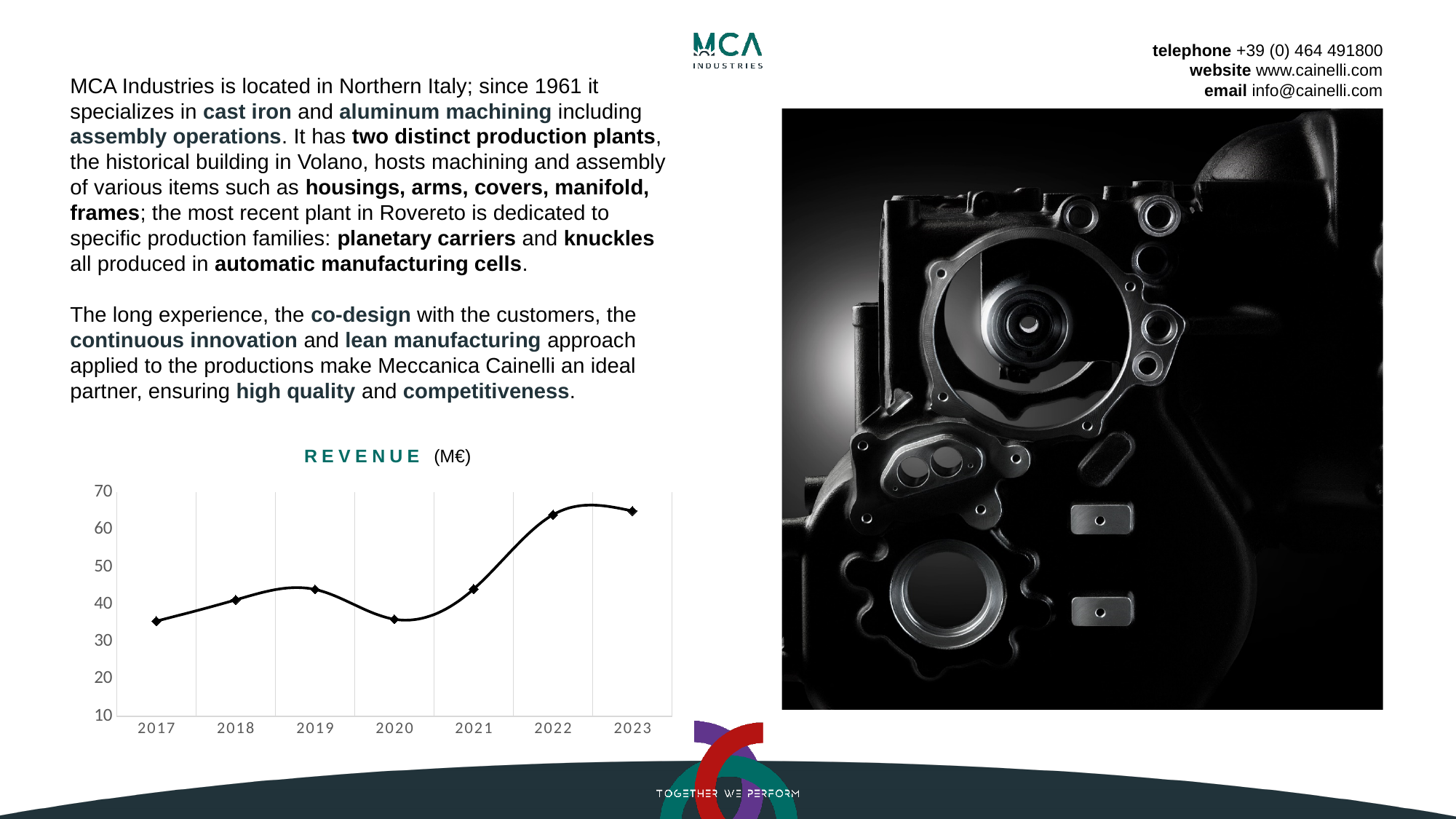
Does revenue rise or fall from 2021 to 2022? rise Which year has the higher revenue, 2019 or 2020? 2019 In what unit is revenue expressed in the chart? M€ Which year has the higher revenue, 2018 or 2022? 2022 Is the revenue value for 2017 greater or less than 40? less Is the revenue value for 2019 greater or less than 40? greater What kind of chart is shown on the slide? line chart How many years are plotted on the x axis of the revenue chart? 7 Is the revenue value for 2023 greater or less than 60? greater What is the title of the chart? REVENUE